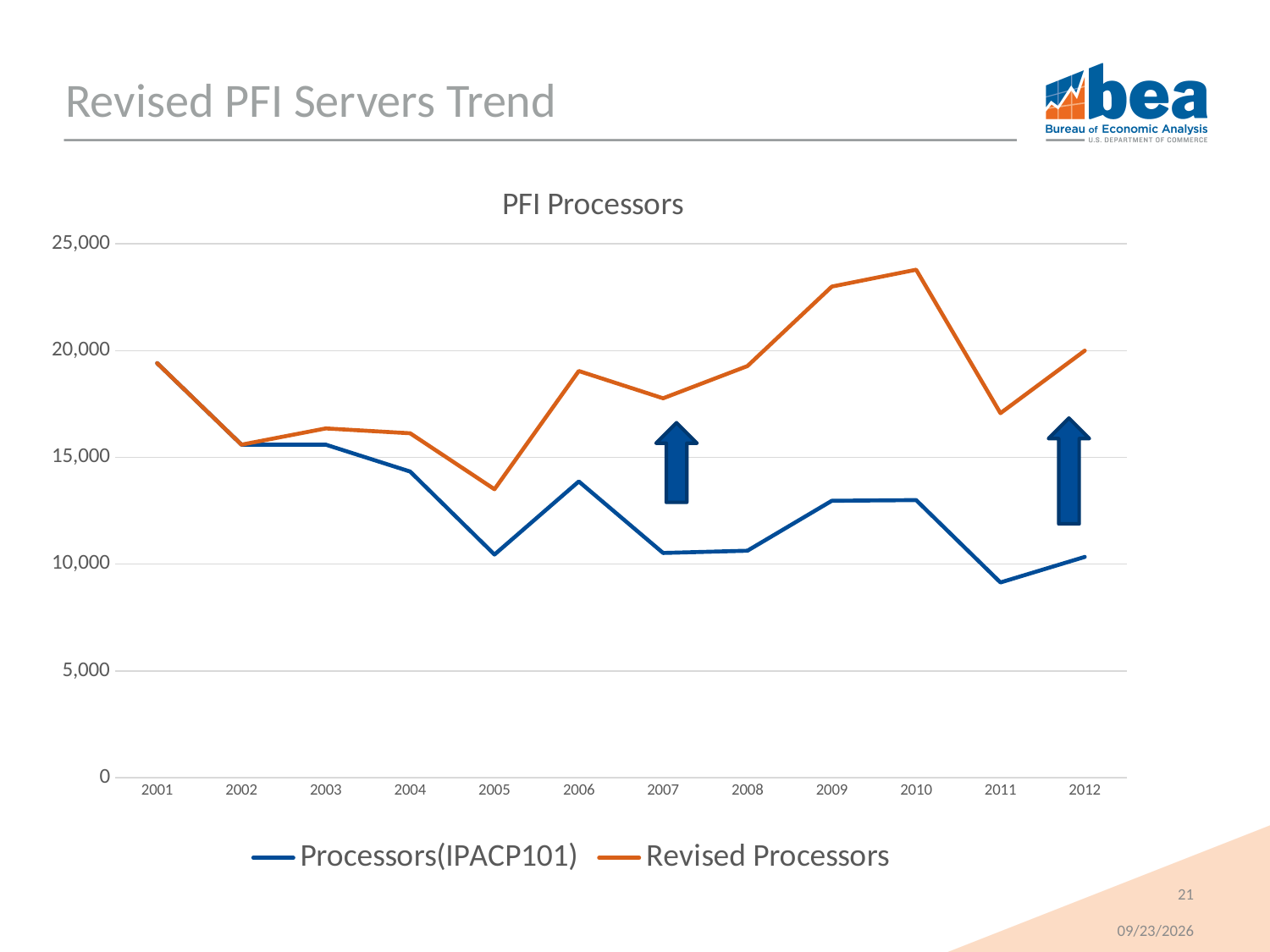
In which year is the Processors(IPACP101) series lowest? 2011 Which series is drawn in orange? Revised Processors How many years are plotted along the x axis? 12 What kind of chart is shown on the slide? line chart Is the value for Revised Processors in 2010 greater or less than 20,000? greater How many series does the legend list? 2 Is the value for Processors(IPACP101) in 2011 greater or less than 10,000? less In which year is the Revised Processors series highest? 2010 What is the title of the chart? PFI Processors In which year is the Revised Processors series lowest? 2005 In 2010, which series has the larger value, Processors(IPACP101) or Revised Processors? Revised Processors Does the Revised Processors series rise or fall from 2008 to 2010? rise